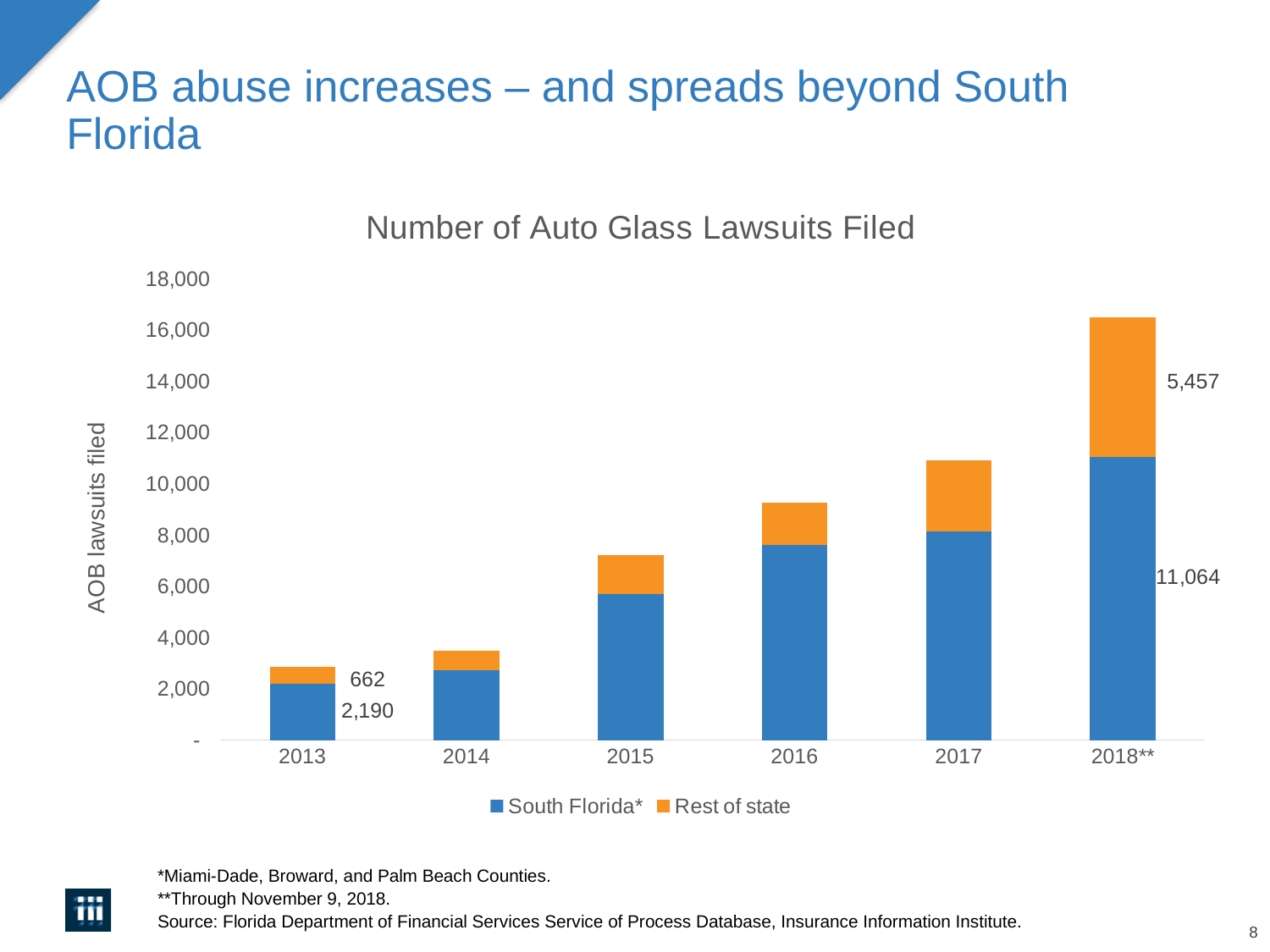
Which year has the highest total number of auto glass lawsuits filed? 2018** How many series does the legend list? 2 What is the total of the stacked bar for 2018**? 16,521 What is the difference between the South Florida* value and the Rest of state value in 2018**? 5,607 What is the value for Rest of state in 2018**? 5,457 What is the value for South Florida* in 2018**? 11,064 How many years are shown on the x axis? 6 What is the value for South Florida* in 2013? 2,190 Which year has the lowest total number of auto glass lawsuits filed? 2013 What is the value for Rest of state in 2013? 662 Is the South Florida* value for 2016 greater or less than 6,000? greater What is the total of the stacked bar for 2013? 2,852